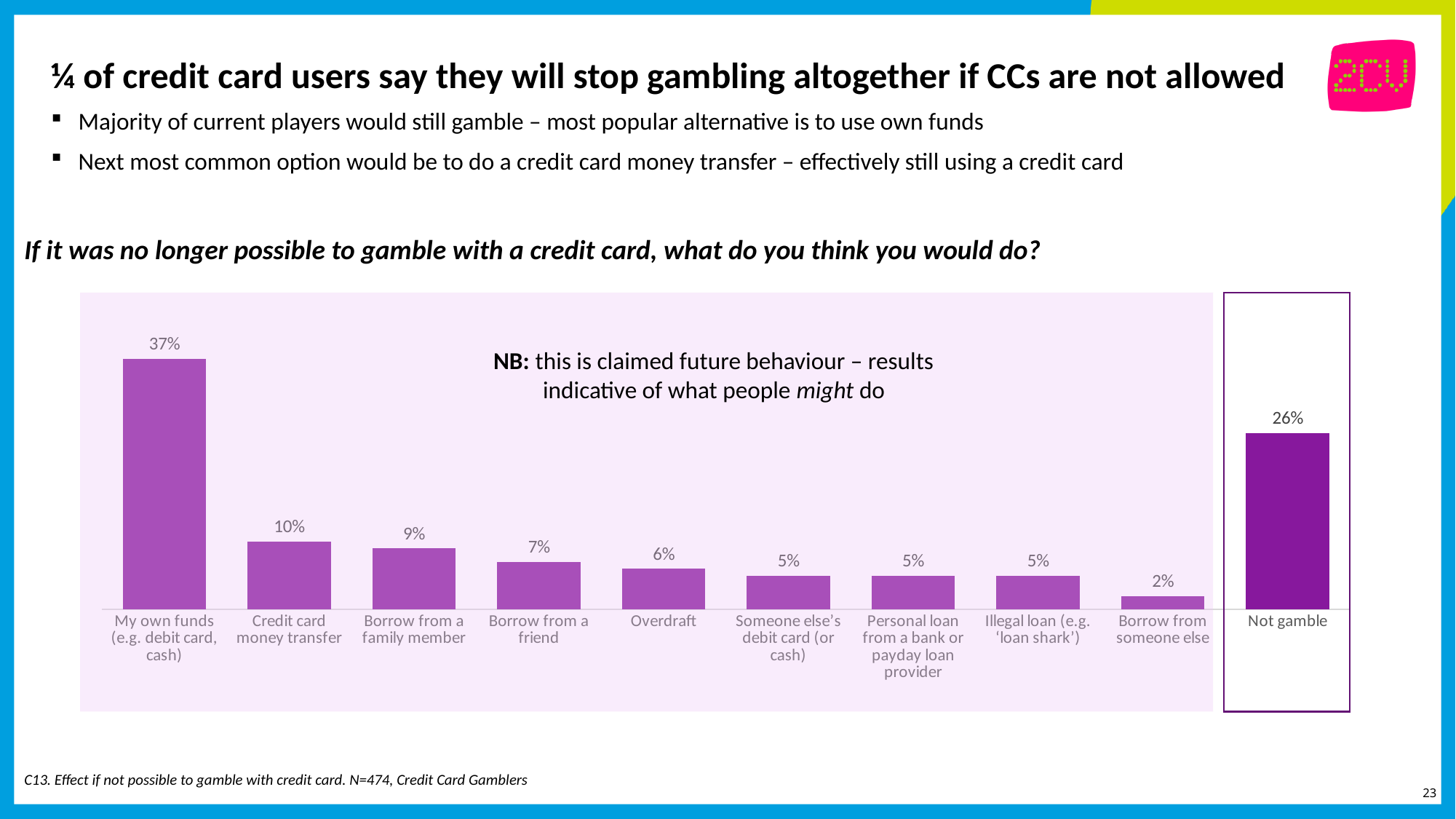
What percentage of respondents say they would not gamble? 26% Which category has the lowest value in the chart? Borrow from someone else What percentage of respondents say they would use their own funds (e.g. debit card, cash)? 37% What is the value for 'Overdraft'? 6% Which category is highlighted in a separate box with a darker purple bar? Not gamble What is the value for 'Credit card money transfer'? 10% What is the difference between 'Borrow from a family member' and 'Borrow from a friend'? 2% How many categories are shown in the chart? 10 What is the difference between 'My own funds' and 'Not gamble'? 11% Which category has the highest value in the chart? My own funds (e.g. debit card, cash) What type of chart is shown on the slide? Bar chart Which is larger: 'Credit card money transfer' or 'Borrow from a family member'? Credit card money transfer